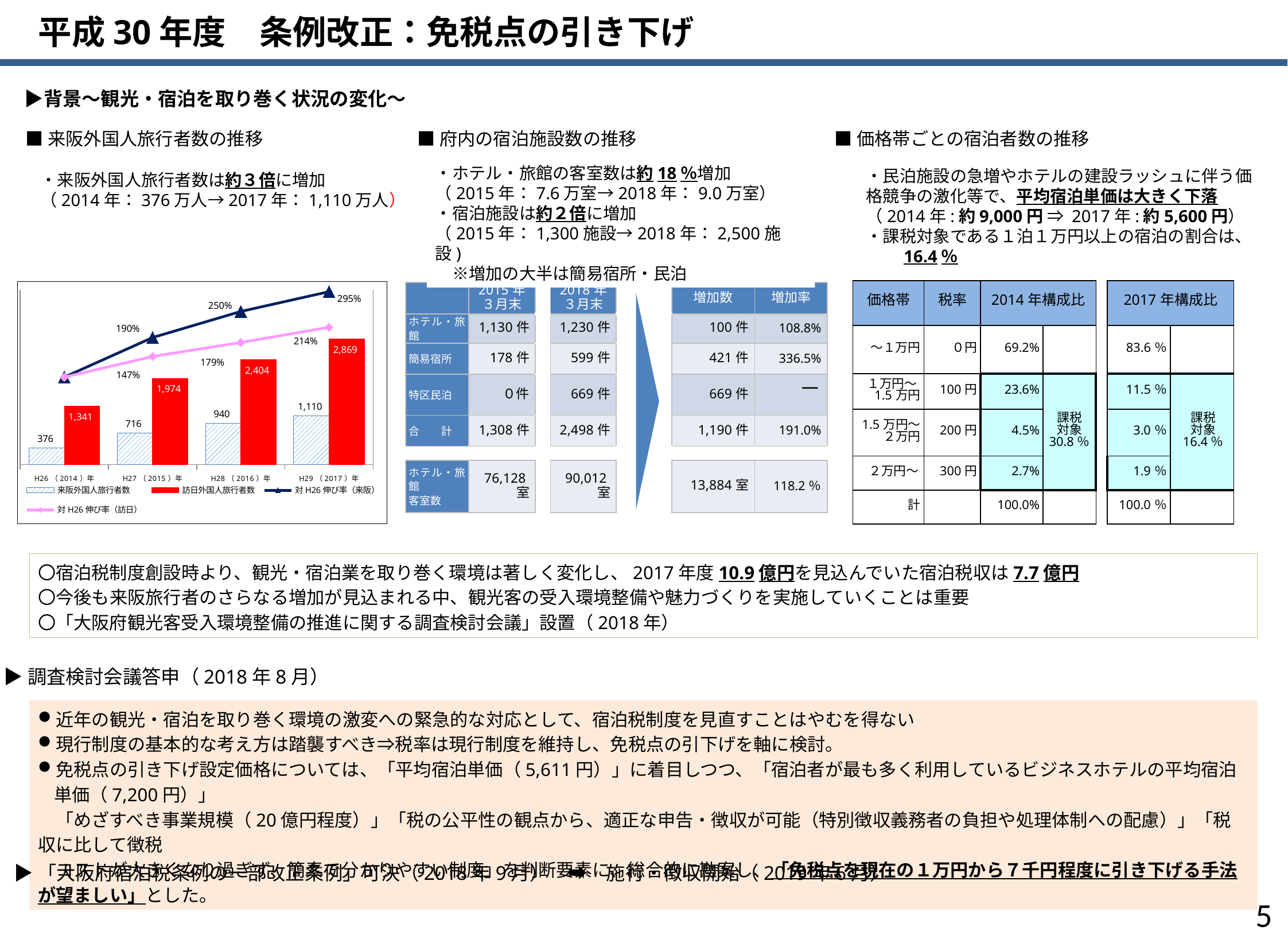
In the chart, which year has the highest value for 来阪外国人旅行者数? H29（2017）年 What type of chart is shown on the slide (the chart under 来阪外国人旅行者数の推移)? Combined bar and line chart In the chart, which year has the lowest value for 訪日外国人旅行者数? H26（2014）年 How many series does the chart's legend list? 4 In the chart, what is the 対H26伸び率（訪日） value for H27（2015）年? 147% In the chart, which is larger for H28（2016）年: 来阪外国人旅行者数 or 訪日外国人旅行者数? 訪日外国人旅行者数 In the chart, does the 来阪外国人旅行者数 series rise or fall from H26（2014）年 to H29（2017）年? Rise In the chart, what is the difference between the 訪日外国人旅行者数 values for H29（2017）年 and H26（2014）年? 1,528 In the chart, what is the value of 訪日外国人旅行者数 for H29（2017）年? 2,869 How many years (categories) are shown on the x axis of the chart? 4 In the chart, what is the 対H26伸び率（来阪） value for H28（2016）年? 250% In the chart, what is the value of 来阪外国人旅行者数 for H26（2014）年? 376